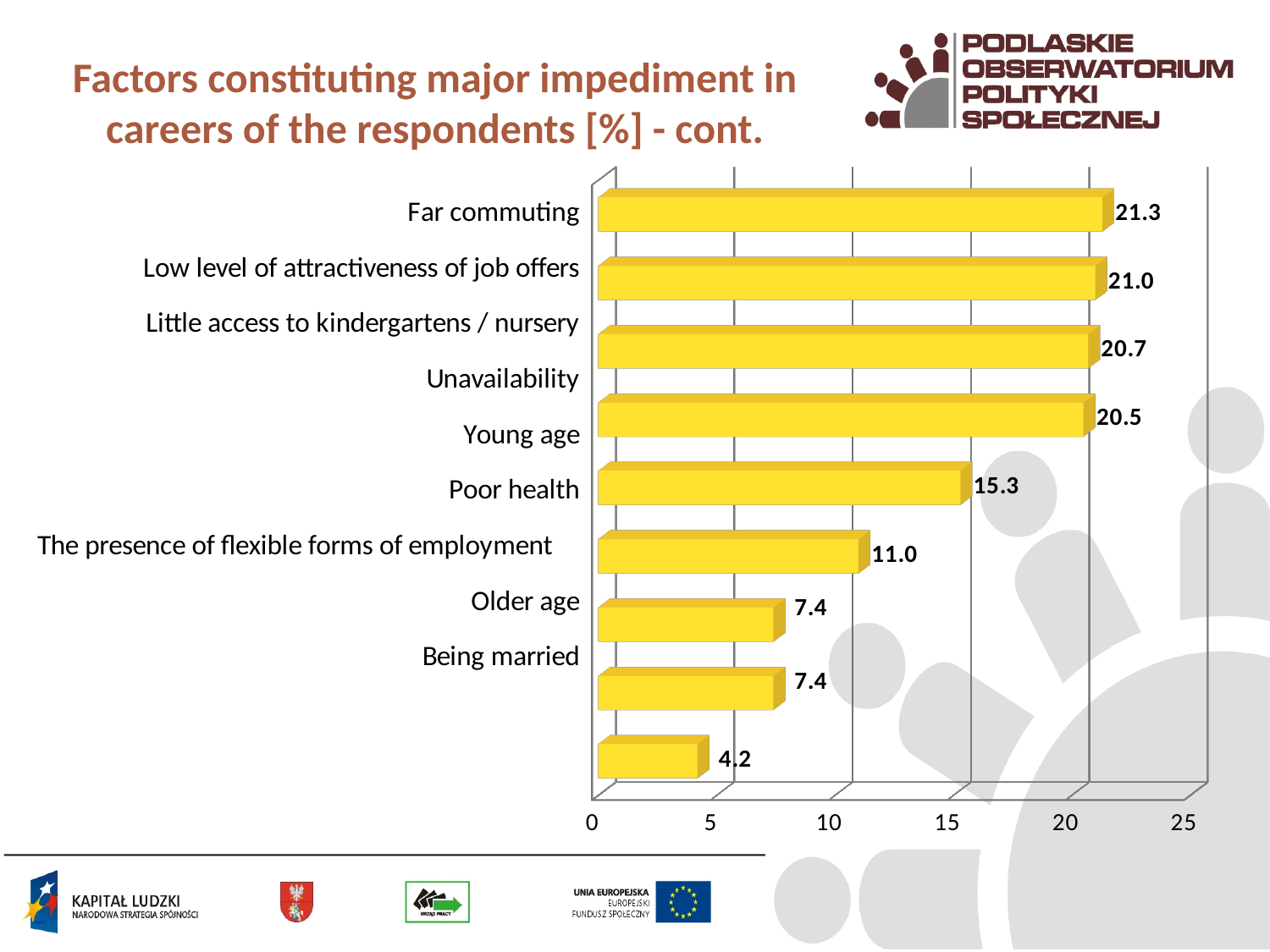
What is the lowest value shown in the chart? 4.2 Which factor has the highest value? Far commuting How many bars are plotted in the chart? 9 What is the difference between the values for Far commuting and Low level of attractiveness of job offers? 0.3 Which is larger, the value for Far commuting or the value for Little access to kindergartens / nursery? Far commuting What kind of chart is shown on the slide? bar chart What is the value for Far commuting? 21.3 What is the title of the chart? Factors constituting major impediment in careers of the respondents [%] - cont. What is the value for Low level of attractiveness of job offers? 21.0 What is the value for Little access to kindergartens / nursery? 20.7 Is the value for Far commuting greater or less than 20? greater What is the maximum value shown on the x axis? 25